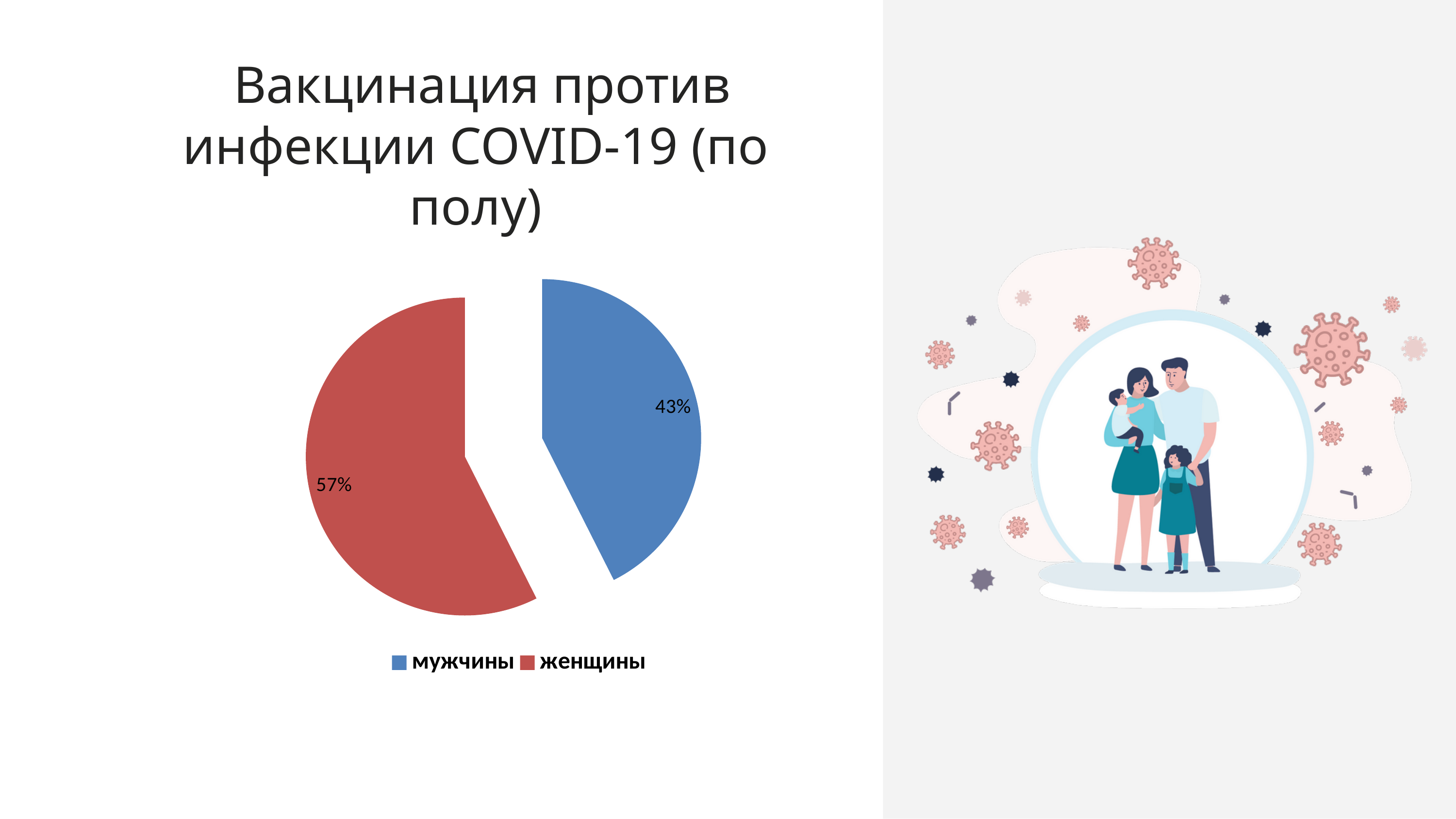
Which category has the largest share of the pie? женщины Which category has the smallest share of the pie? мужчины Which is larger, the share for мужчины or the share for женщины? женщины What is the value for женщины? 57% What is the difference between the share for женщины and the share for мужчины? 14% What is the value for мужчины? 43% What colour is the slice for мужчины? blue What kind of chart is shown on the slide? pie chart How many slices does the pie chart have? 2 What is the title of the chart? Вакцинация против инфекции COVID-19 (по полу) How many entries does the legend list? 2 What share of the pie does the женщины slice represent? 57%